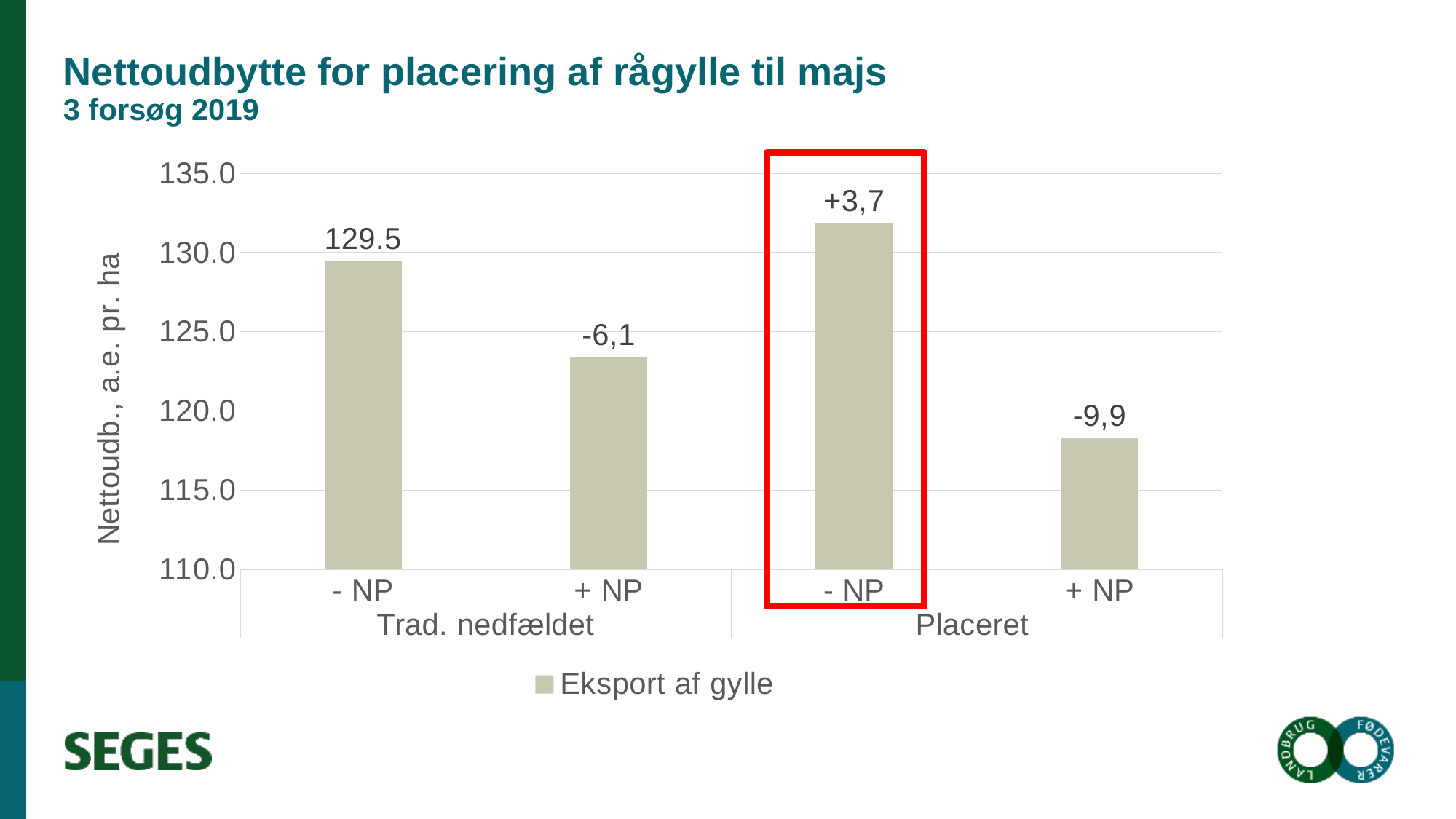
How many series does the legend list? 1 What kind of chart is shown on the slide? bar chart Which bar is the tallest in the chart? - NP under Placeret Is the bar for '- NP' under 'Placeret' greater or less than 130.0? greater Is the bar for '+ NP' under 'Placeret' greater or less than 120.0? less How many bars are plotted in the chart? 4 What is the data label printed above the '+ NP' bar under 'Trad. nedfældet'? -6,1 What is the data label printed above the '- NP' bar under 'Placeret'? +3,7 What is the legend entry shown below the chart? Eksport af gylle What is the data label printed above the '- NP' bar under 'Trad. nedfældet'? 129.5 What is the data label printed above the '+ NP' bar under 'Placeret'? -9,9 Which bar is the shortest in the chart? + NP under Placeret